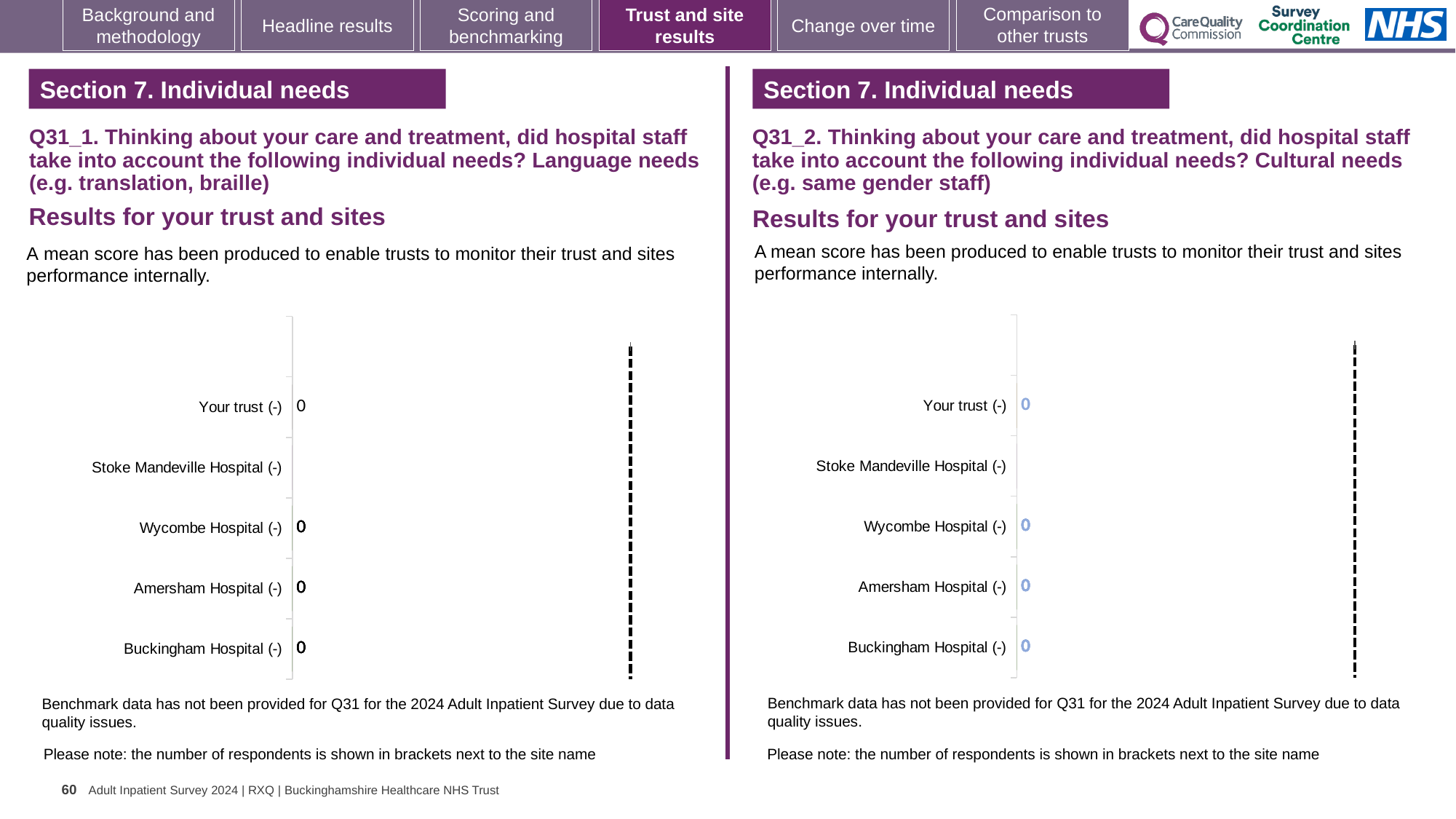
On the right chart (Q31_2, Cultural needs), what value is shown for Your trust (-)? 0 On the left chart (Q31_1, Language needs), what value is shown for Wycombe Hospital (-)? 0 On the left chart (Q31_1, Language needs), what value is shown for Your trust (-)? 0 On the right chart (Q31_2, Cultural needs), which category is listed first at the top? Your trust (-) On the left chart (Q31_1, Language needs), which category has no data label shown? Stoke Mandeville Hospital (-) How many categories are listed on the left chart (Q31_1, Language needs)? 5 On the right chart (Q31_2, Cultural needs), what value is shown for Buckingham Hospital (-)? 0 What kind of chart is the left chart (Q31_1, Language needs)? Bar chart On the left chart (Q31_1, Language needs), what value is shown for Buckingham Hospital (-)? 0 How many categories are listed on the right chart (Q31_2, Cultural needs)? 5 On the right chart (Q31_2, Cultural needs), what value is shown for Amersham Hospital (-)? 0